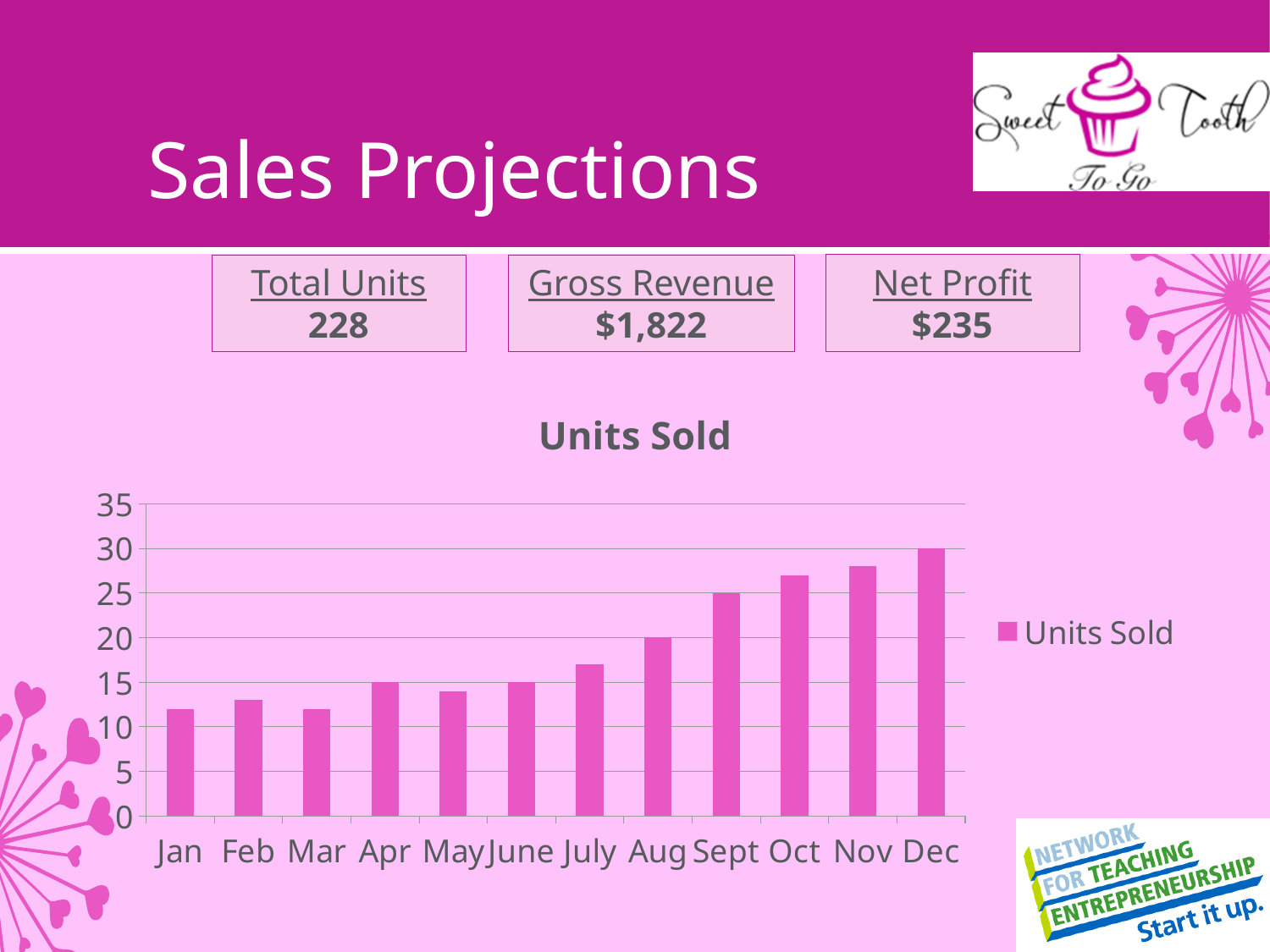
Do the units sold generally rise or fall from Jan to Dec? rise What kind of chart is shown on the slide? bar chart What is the value for Dec in the Units Sold chart? 30 How many series does the chart's legend list? 1 What is the value for Aug in the Units Sold chart? 20 What is the value for Sept in the Units Sold chart? 25 Which is larger, the units sold in Dec or in Jan? Dec Which month has the highest units sold? Dec Is the value for Oct greater or less than 25? greater How many months are plotted on the x axis of the chart? 12 What is the title of the chart? Units Sold Is the value for Jan greater or less than 15? less